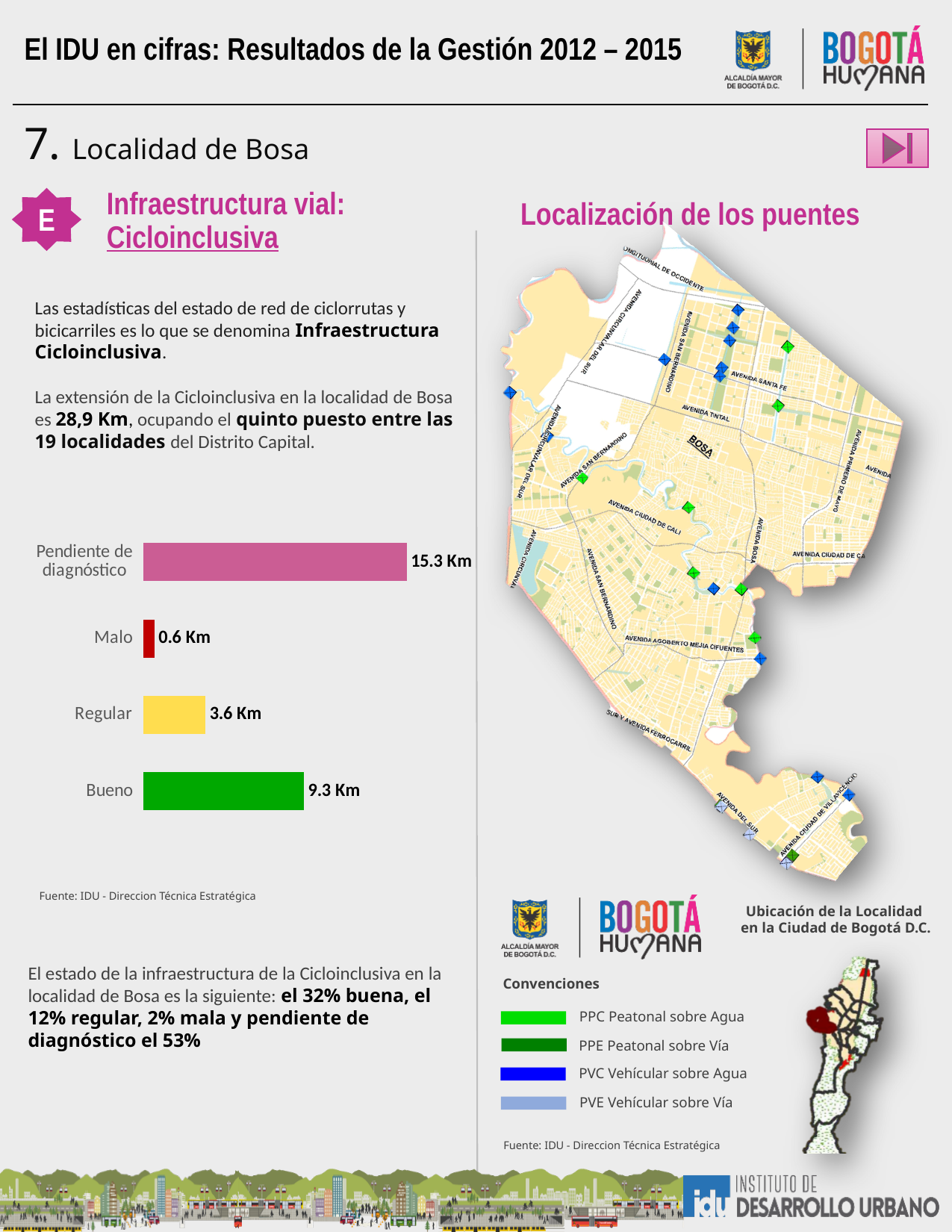
What is the difference between the values for Pendiente de diagnóstico and Bueno in the bar chart? 6.0 Km What is the value for Malo in the bar chart? 0.6 Km What is the value for Regular in the bar chart? 3.6 Km What is the value for Pendiente de diagnóstico in the bar chart? 15.3 Km What is the value for Bueno in the bar chart? 9.3 Km What colour is the bar for Bueno in the bar chart? Green What is the difference between the values for Regular and Malo in the bar chart? 3.0 Km How many categories are shown in the bar chart? 4 Which category has the lowest value in the bar chart? Malo Which is larger in the bar chart, Bueno or Regular? Bueno Which category has the highest value in the bar chart? Pendiente de diagnóstico What kind of chart is shown on the left of the slide? Bar chart